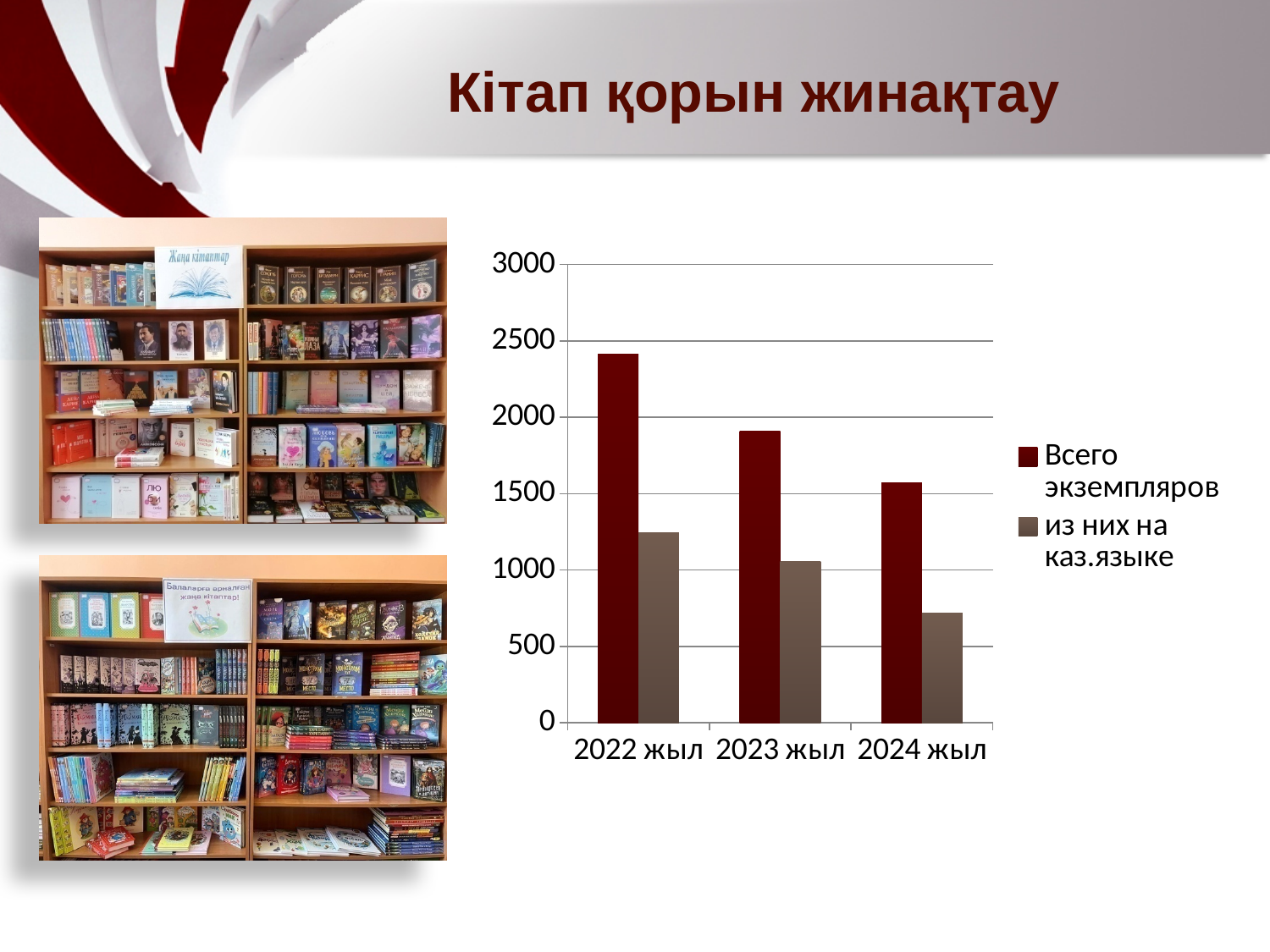
Is the value for 'из них на каз.языке' in 2022 жыл greater or less than 1000? greater What kind of chart is shown on the slide? bar chart Is the value for 'из них на каз.языке' in 2024 жыл greater or less than 1000? less What is the title of the slide containing the chart? Кітап қорын жинақтау How many year categories are shown on the x axis of the chart? 3 Is the value for 'Всего экземпляров' in 2022 жыл greater or less than 2000? greater Which year has the highest value for 'Всего экземпляров'? 2022 жыл How many series does the chart legend list? 2 Which is larger: 'Всего экземпляров' in 2023 жыл or 'Всего экземпляров' in 2024 жыл? 2023 жыл Which year has the lowest value for 'из них на каз.языке'? 2024 жыл Do the values for 'Всего экземпляров' rise or fall from 2022 жыл to 2024 жыл? fall